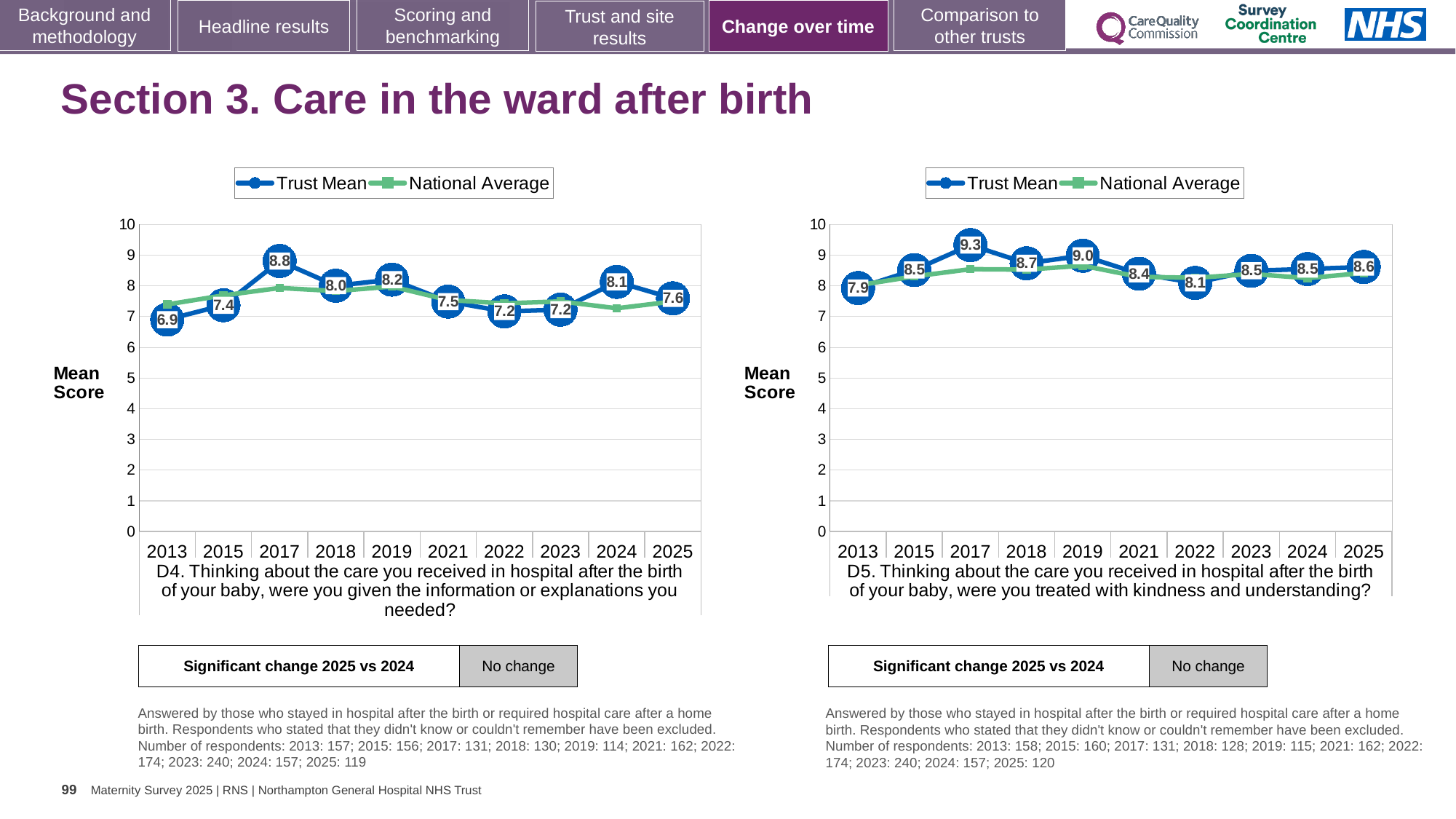
In the D4 chart (left), what is the difference between the Trust Mean in 2017 and in 2013? 1.9 In the D4 chart (left), is the Trust Mean higher in 2024 or in 2025? 2024 How many series does the legend of the D5 chart (right) list? 2 What type of chart is the D4 chart (left)? Line chart In the D4 chart (left), what is the Trust Mean for 2017? 8.8 In the D5 chart (right), what is the Trust Mean for 2019? 9.0 In the D5 chart (right), what is the difference between the Trust Mean in 2025 and in 2013? 0.7 In the D5 chart (right), is the National Average for 2013 greater or less than 7? greater In the D5 chart (right), which year has the highest Trust Mean? 2017 How many years are plotted on the x axis of the D4 chart (left)? 10 In the D4 chart (left), what is the Trust Mean for 2025? 7.6 In the D4 chart (left), which year has the lowest Trust Mean? 2013